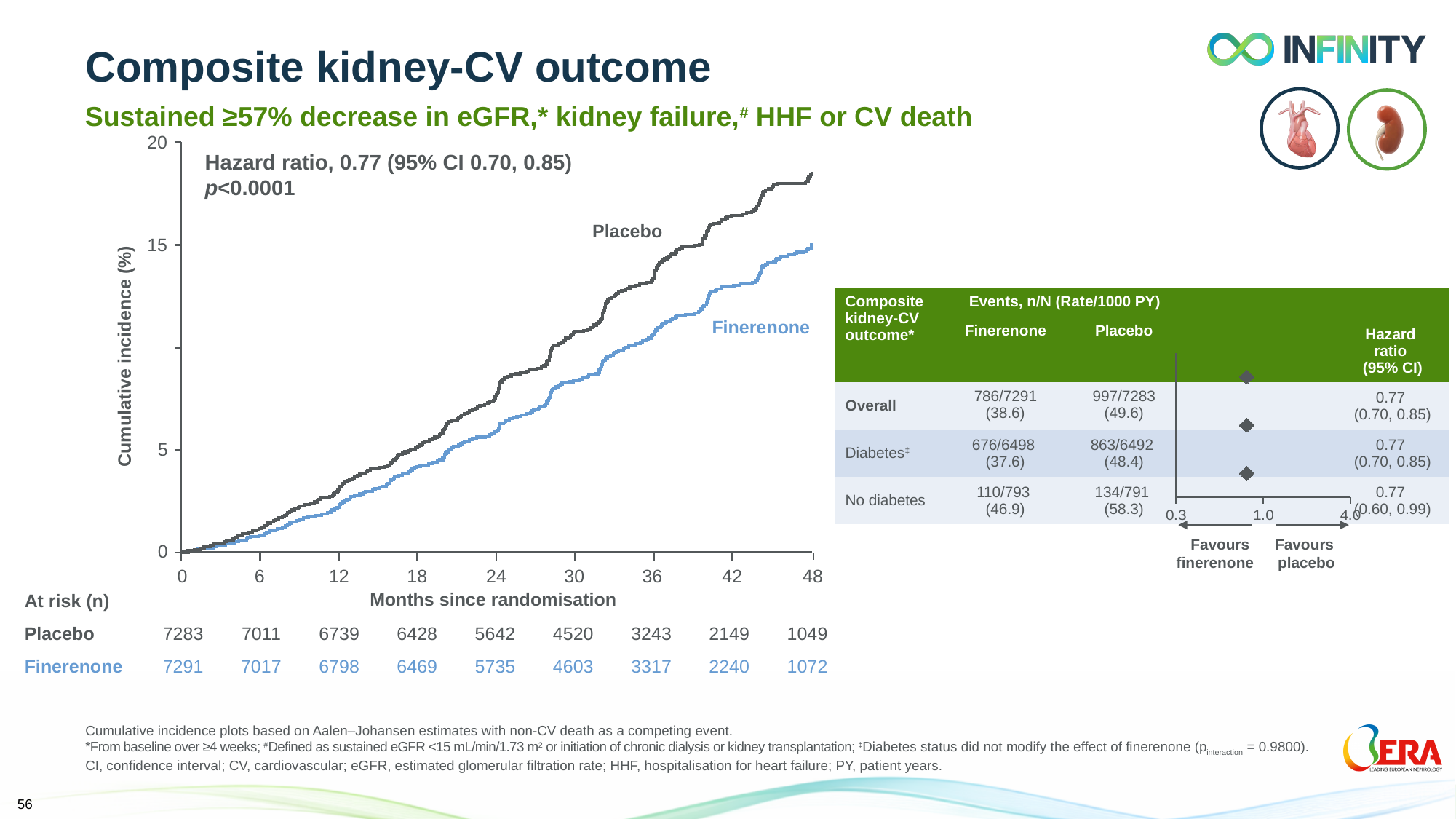
In the cumulative incidence chart, is the Finerenone cumulative incidence at 24 months greater or less than 10%? less What kind of chart is the cumulative incidence plot on the left of the slide? Line chart How many treatment groups are plotted in the cumulative incidence chart? 2 In the cumulative incidence chart, is the Placebo cumulative incidence at 48 months greater or less than 15%? greater In the cumulative incidence chart, do the curves rise or fall as months since randomisation increase? Rise What p-value is printed on the cumulative incidence chart? p<0.0001 In the forest plot on the right, how many subgroup rows are plotted? 3 In the forest plot on the right, what is the hazard ratio (95% CI) for the No diabetes subgroup? 0.77 (0.60, 0.99) What hazard ratio and 95% CI are printed on the cumulative incidence chart? 0.77 (95% CI 0.70, 0.85) In the at-risk table below the cumulative incidence chart, how many Finerenone patients were at risk at 48 months? 1072 In the at-risk table below the cumulative incidence chart, how many Placebo patients were at risk at 0 months? 7283 In the cumulative incidence chart, which group has the higher cumulative incidence at 48 months, Placebo or Finerenone? Placebo